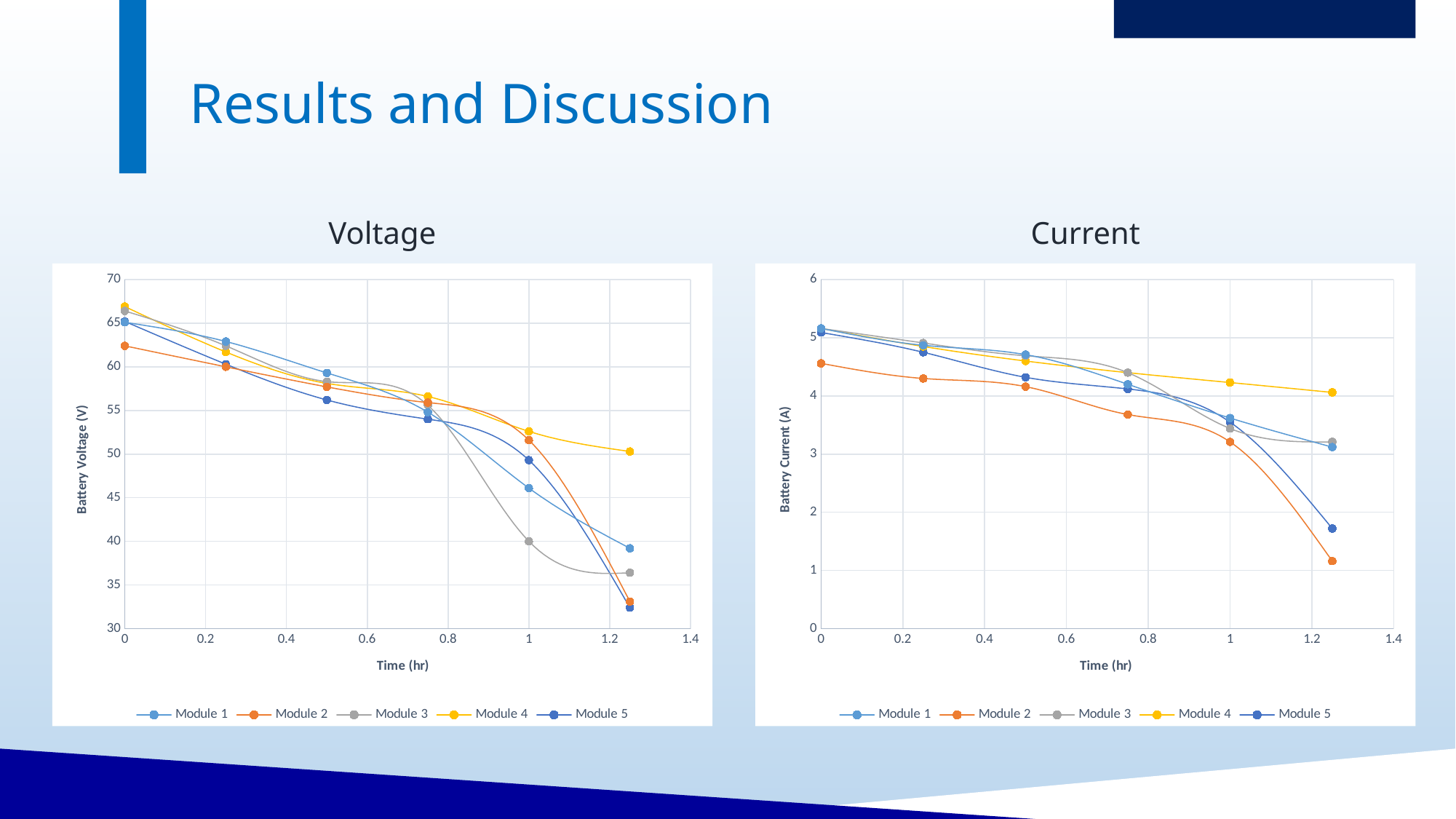
What is the title of the vertical axis of the Current chart? Battery Current (A) In the Voltage chart, how many data points are plotted for Module 4? 6 In the Current chart, which module has the lowest current at 1.25 hr? Module 2 In the Voltage chart, which module has the highest voltage at 1.25 hr? Module 4 In the Voltage chart, do the values for Module 1 rise or fall as time increases? fall In the Voltage chart, at 1 hr, which is larger: the value for Module 4 or the value for Module 3? Module 4 How many series does the legend of the Current chart list? 5 In the Current chart, do the values for Module 2 rise or fall as time increases? fall In the Voltage chart, is the value for Module 5 at 1.25 hr greater or less than 35? less In the Current chart, is the value for Module 4 at 1.25 hr greater or less than 3? greater In the Voltage chart, which module has the lowest voltage at 0 hr? Module 2 What kind of chart is the Voltage chart? line chart